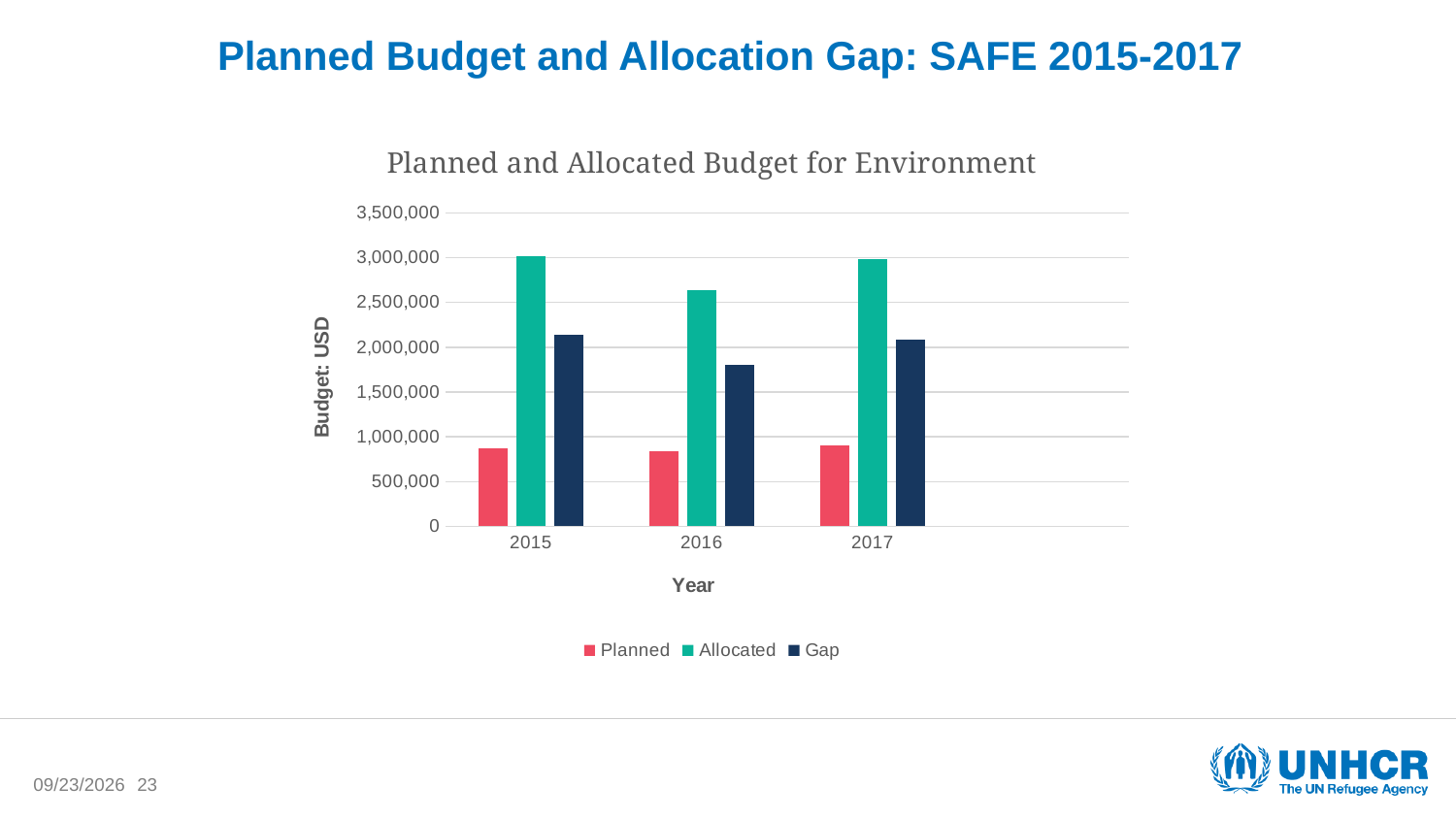
In 2017, which is larger, the Allocated budget or the Gap? Allocated How many series does the legend list? 3 Is the Allocated value for 2015 greater or less than 2,500,000? greater What is the title of the chart? Planned and Allocated Budget for Environment Is the Allocated value for 2016 greater or less than 2,500,000? greater Is the Gap value for 2016 greater or less than 2,000,000? less Which year has the lowest Gap? 2016 How many years are shown on the x axis? 3 What kind of chart is shown on the slide? bar chart Which is larger, the Gap in 2015 or the Gap in 2016? Gap in 2015 Which year has the lowest Allocated budget? 2016